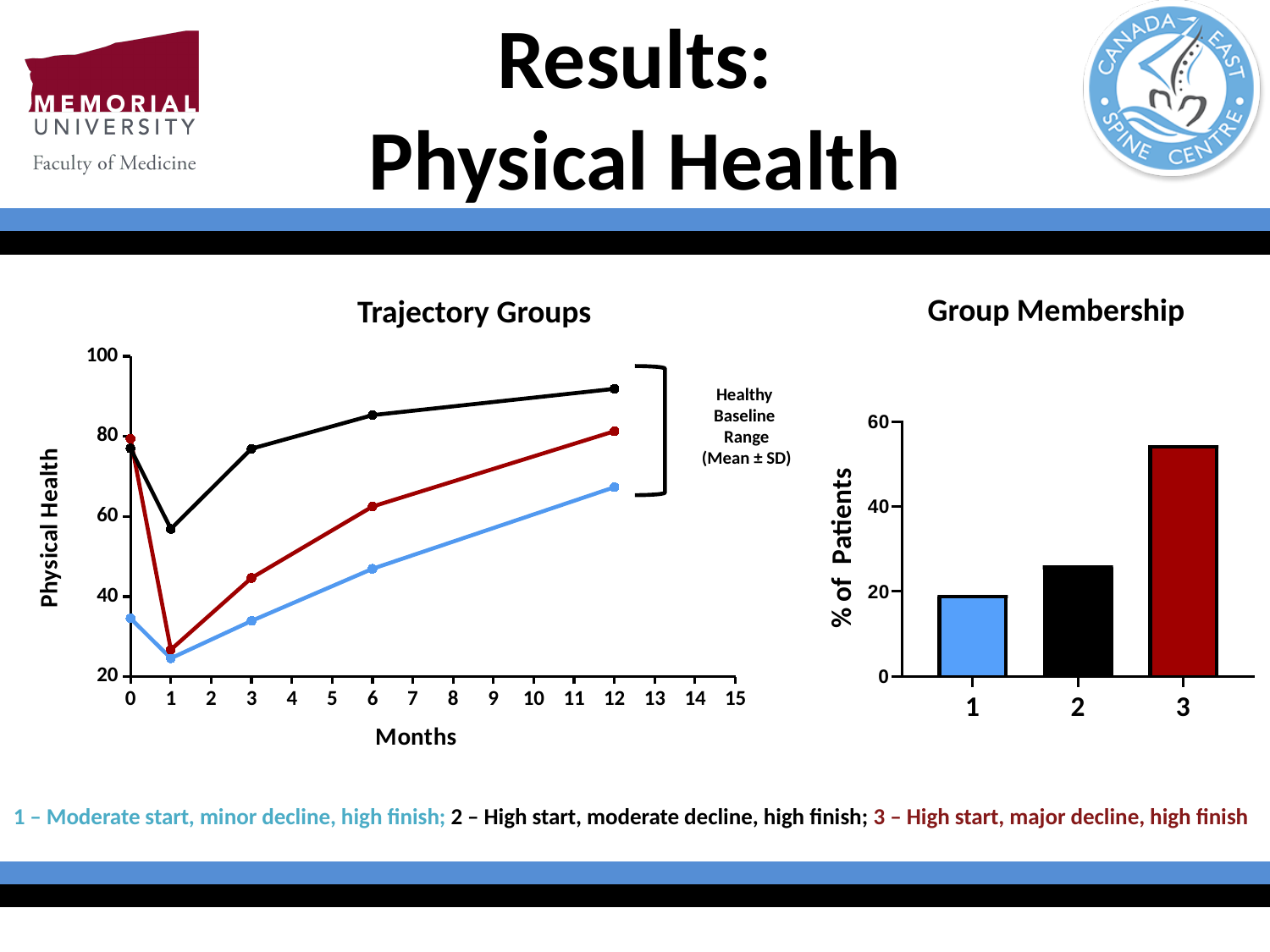
What kind of chart is the Trajectory Groups chart? line chart In the Trajectory Groups chart, is the red line's value at month 1 greater or less than 40? less In the Trajectory Groups chart, which coloured line has the highest Physical Health value at month 12? black How many bars are shown in the Group Membership chart? 3 In the Group Membership chart, which group has the lowest % of patients? 1 In the Group Membership chart, which group has the highest % of patients? 3 In the Group Membership chart, is the value for group 3 greater or less than 40? greater In the Trajectory Groups chart, does the blue line rise or fall from month 1 to month 12? rise In the Trajectory Groups chart, at month 6, is the red line or the blue line higher? red How many lines are plotted in the Trajectory Groups chart? 3 What kind of chart is the Group Membership chart? bar chart